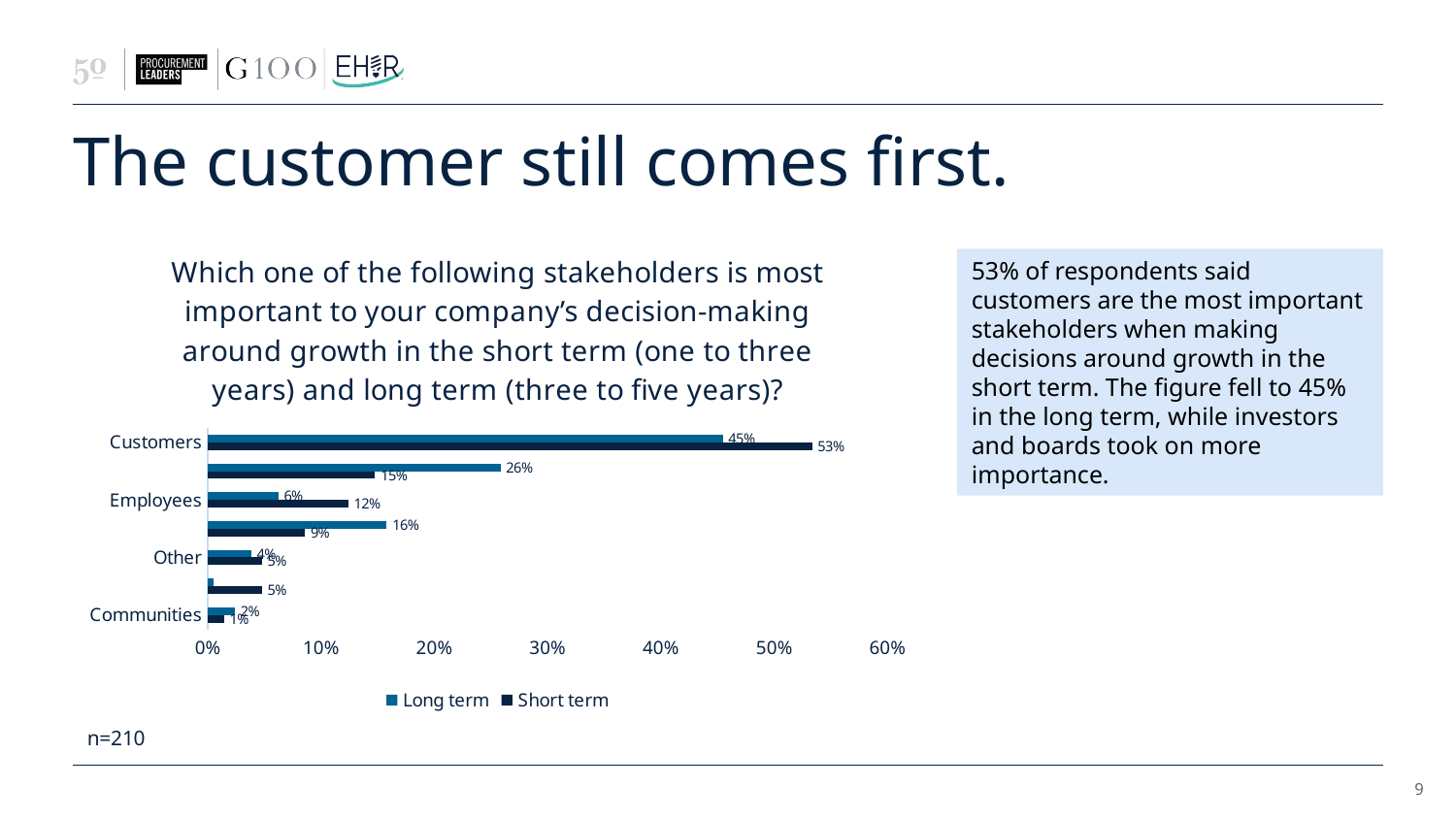
Is the Long term value for Employees greater or less than 10%? less For Customers, which is larger: the Long term value or the Short term value? Short term What is the Short term value for Employees? 12% What is the difference between the Short term and Long term values for Customers? 8 percentage points What kind of chart is shown on the slide? Bar chart Which category has the lowest Short term value? Communities Which category has the highest Short term value? Customers What is the Long term value for Customers? 45% How many series does the legend list? 2 What is the Short term value for Customers? 53% What is the difference between the Short term and Long term values for Employees? 6 percentage points What is the Long term value for Employees? 6%